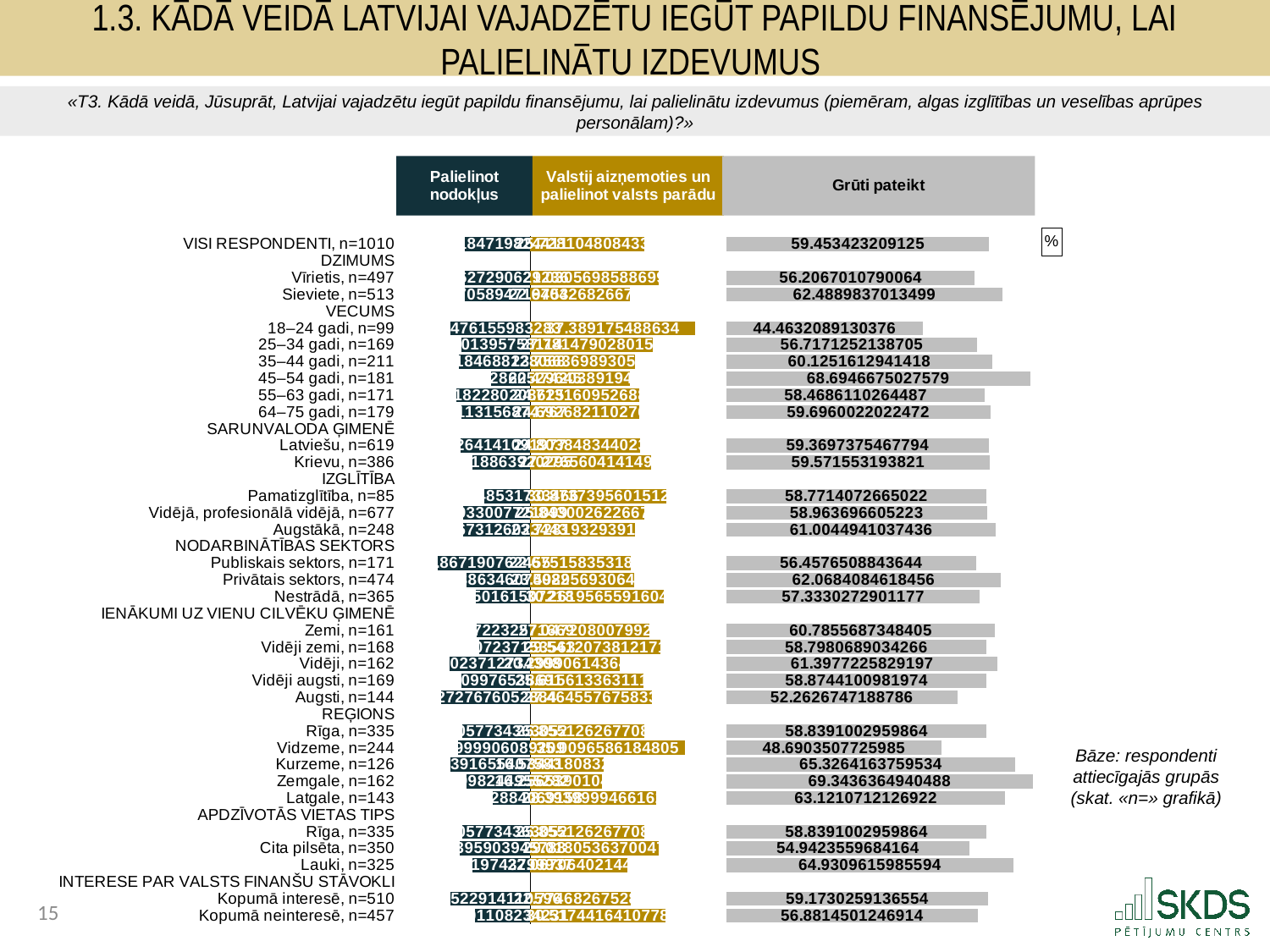
What kind of chart is shown on the slide? bar chart Which group has the highest "Grūti pateikt" value? Zemgale, n=162 How many series does the chart legend list? 3 Which group has the lowest "Grūti pateikt" value? 18–24 gadi, n=99 What is the "Grūti pateikt" value for Sieviete, n=513? 62.4889837013499 What is the label of the third series in the chart legend? Grūti pateikt What is the "Grūti pateikt" value for Zemgale, n=162? 69.3436364940488 What is the "Grūti pateikt" value for VISI RESPONDENTI, n=1010? 59.453423209125 What is the "Grūti pateikt" value for Augsti, n=144? 52.2626747188786 Which has the larger "Grūti pateikt" value: Publiskais sektors, n=171 or Privātais sektors, n=474? Privātais sektors, n=474 Which has the larger "Grūti pateikt" value: Rīga, n=335 or Vidzeme, n=244? Rīga, n=335 What is the difference between the "Grūti pateikt" values for Sieviete, n=513 and Vīrietis, n=497? 6.2822826223435